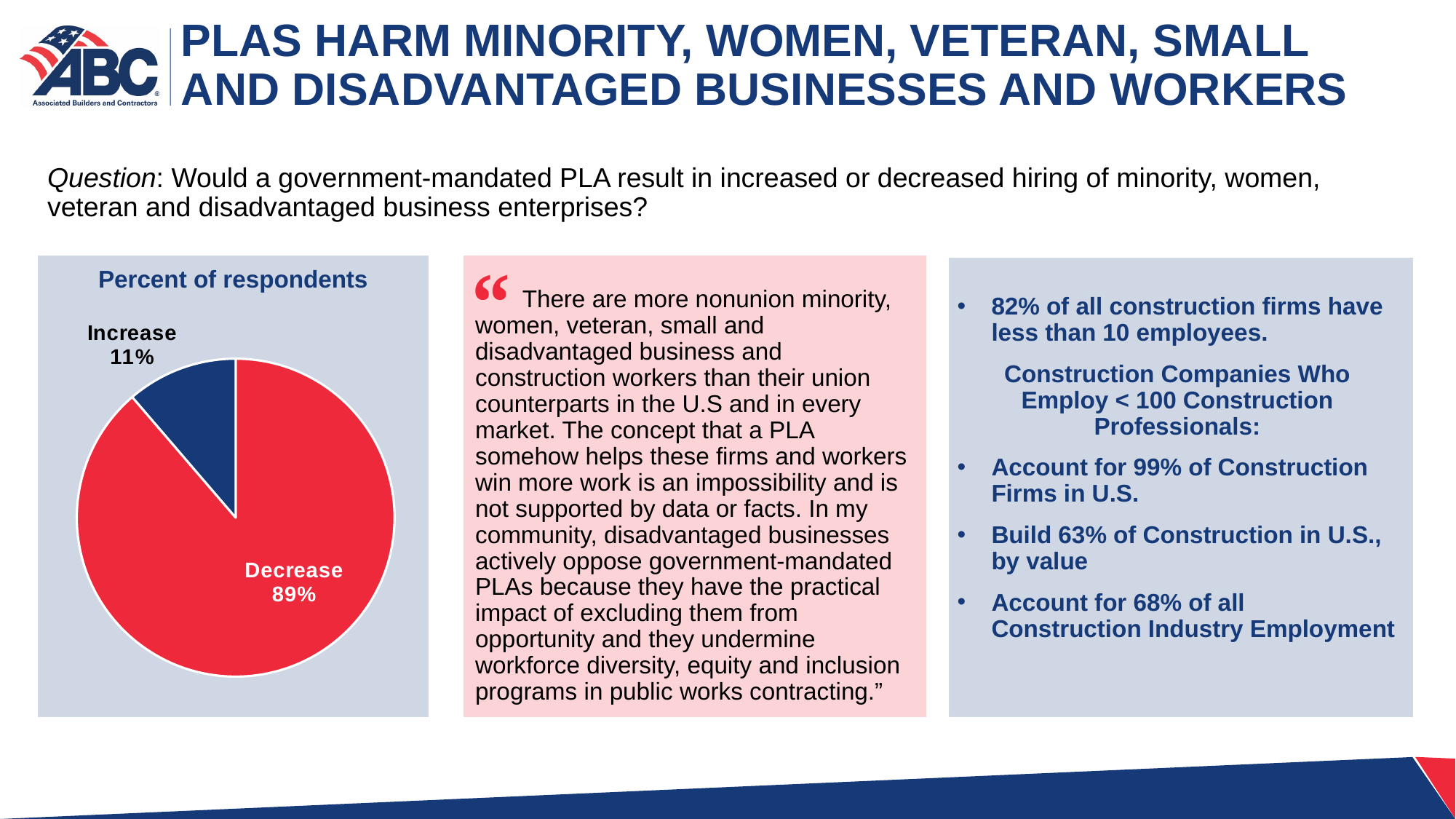
What percentage of respondents said a government-mandated PLA would result in an increase? 11% Which response has the smallest share of the pie? Increase Which response has the largest share of the pie? Decrease How many slices does the pie chart have? 2 What kind of chart is shown on the slide? Pie chart What is the title of the chart? Percent of respondents What colour is the Decrease slice of the pie chart? Red Which is larger, the Increase slice or the Decrease slice? Decrease What share of the pie does the Increase slice represent? 11% What percentage of respondents said a government-mandated PLA would result in a decrease? 89% What is the difference in percentage points between the Decrease and Increase slices? 78